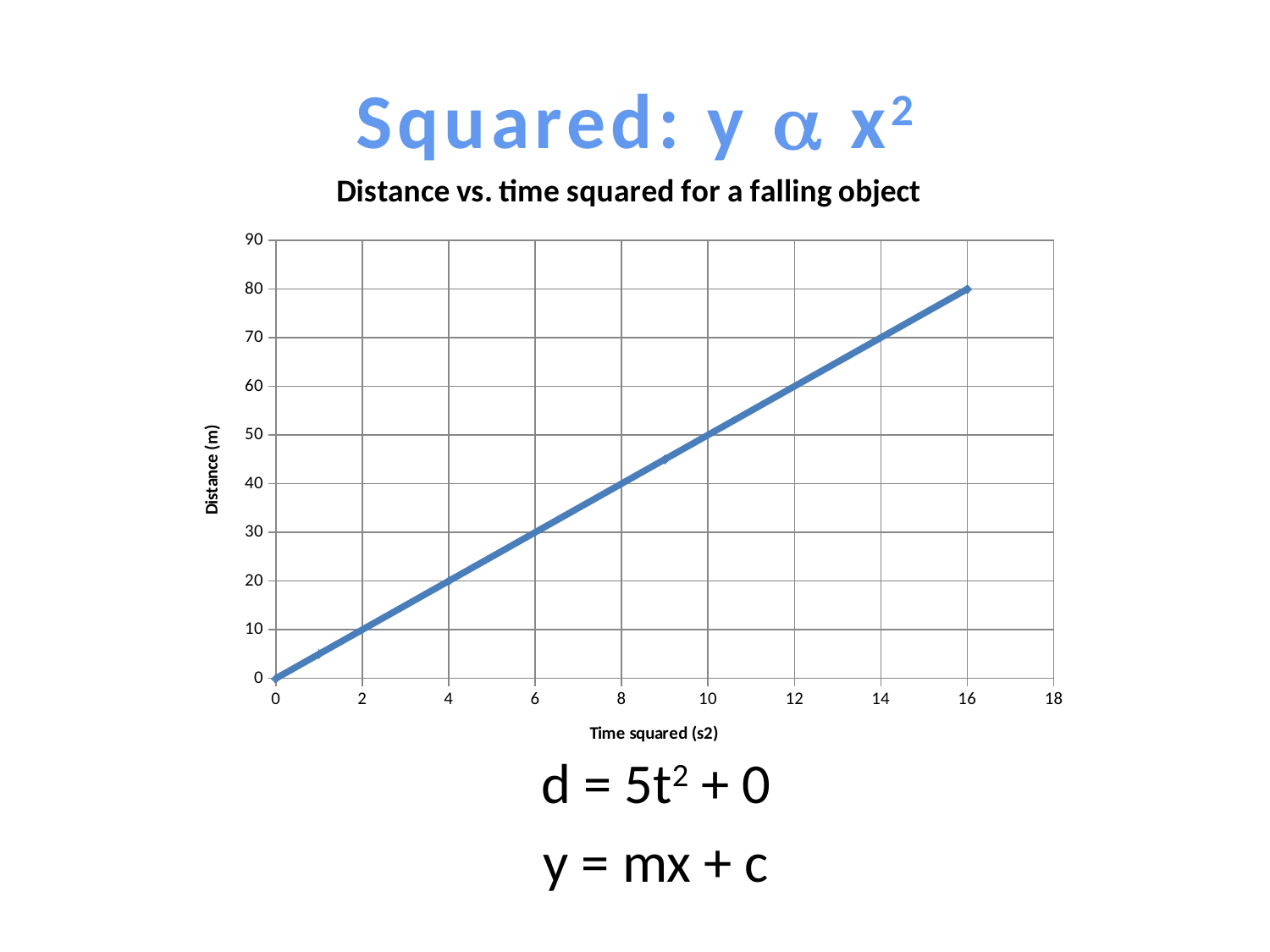
What type of chart is shown on the slide? Line chart Is the distance at time squared 9 greater or less than 40? greater What is the difference in distance between time squared 16 and time squared 4? 60 What is the distance when time squared is 4? 20 What is the distance when time squared is 16? 80 Does the distance rise or fall as time squared increases? Rises What is the label of the vertical axis? Distance (m) Which is larger, the distance at time squared 9 or at time squared 4? Time squared 9 Is the distance at time squared 1 greater or less than 10? less What is the title of the chart? Distance vs. time squared for a falling object At which plotted value of time squared is the distance highest? 16 What is the distance when time squared is 0? 0